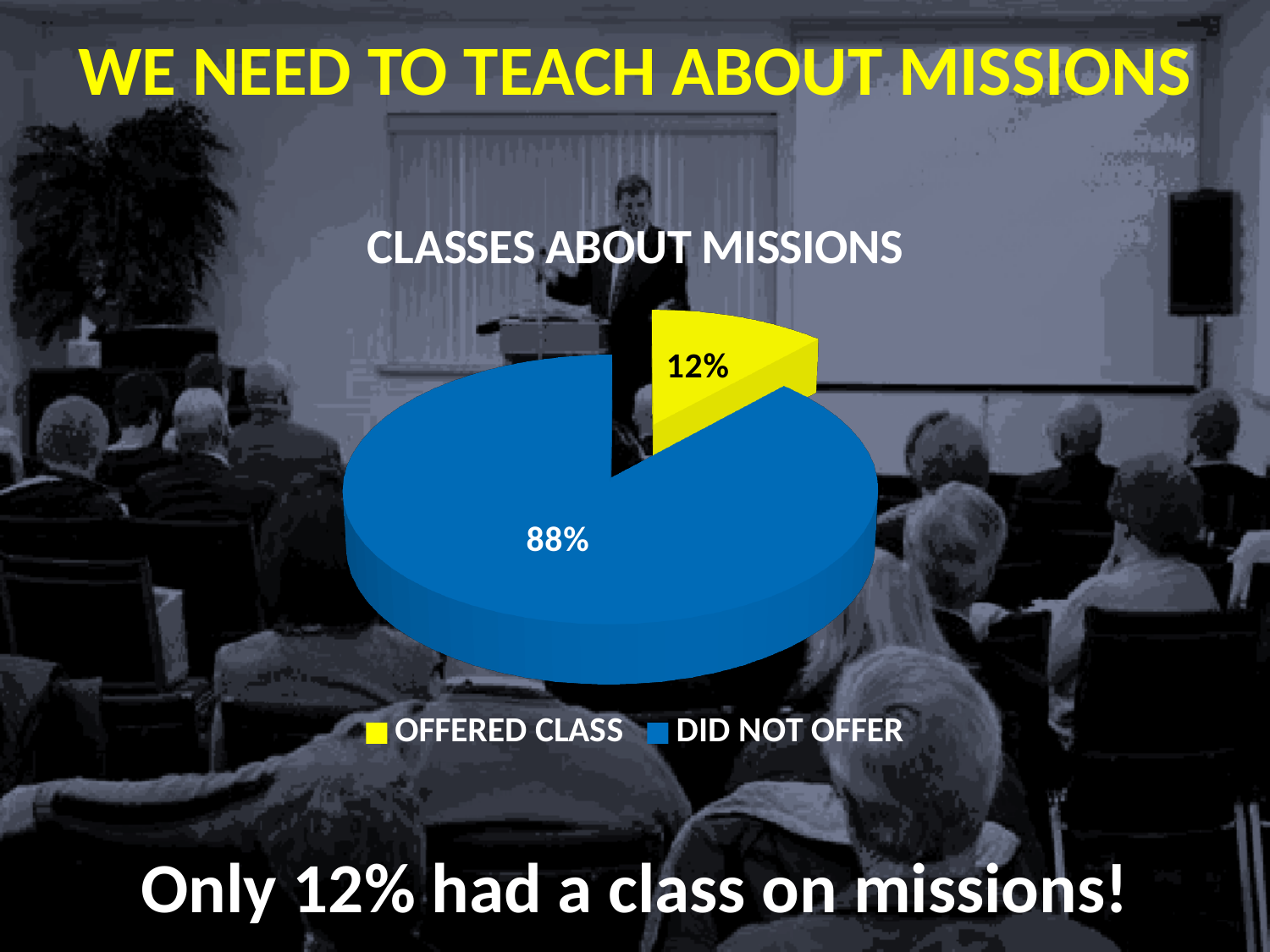
What share of the pie does the OFFERED CLASS slice represent? 12% What percentage of the pie is labelled OFFERED CLASS? 12% What kind of chart is shown on the slide? Pie chart How many entries does the legend list? 2 What is the difference in percentage points between the DID NOT OFFER slice and the OFFERED CLASS slice? 76 What is the title of the chart? CLASSES ABOUT MISSIONS Which is larger, the OFFERED CLASS slice or the DID NOT OFFER slice? DID NOT OFFER Which slice of the pie is the largest? DID NOT OFFER What percentage of the pie is labelled DID NOT OFFER? 88% Which slice of the pie is the smallest? OFFERED CLASS What colour is the OFFERED CLASS slice? Yellow How many slices does the pie chart have? 2